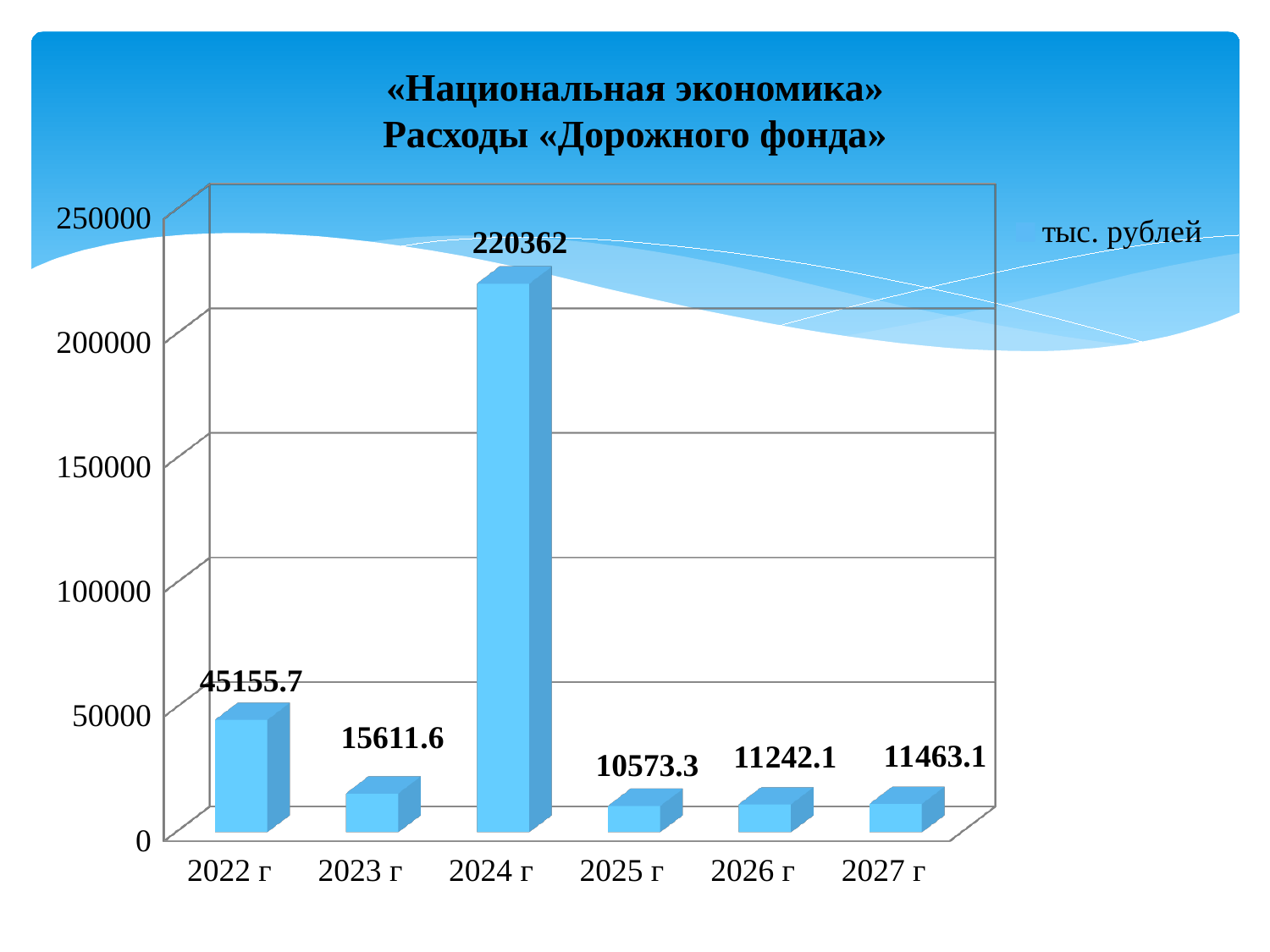
Which year has the lowest value? 2025 г What unit of measurement is indicated next to the chart? тыс. рублей Which is larger, the value for 2023 г or the value for 2025 г? 2023 г How many years are shown on the x axis? 6 What is the difference between the values for 2027 г and 2026 г? 221 Is the value for 2022 г greater or less than 50000? less What is the difference between the values for 2024 г and 2022 г? 175206.3 What kind of chart is shown on the slide? bar chart What is the value for 2024 г? 220362 What is the value for 2025 г? 10573.3 What is the value for 2022 г? 45155.7 Which year has the highest value? 2024 г